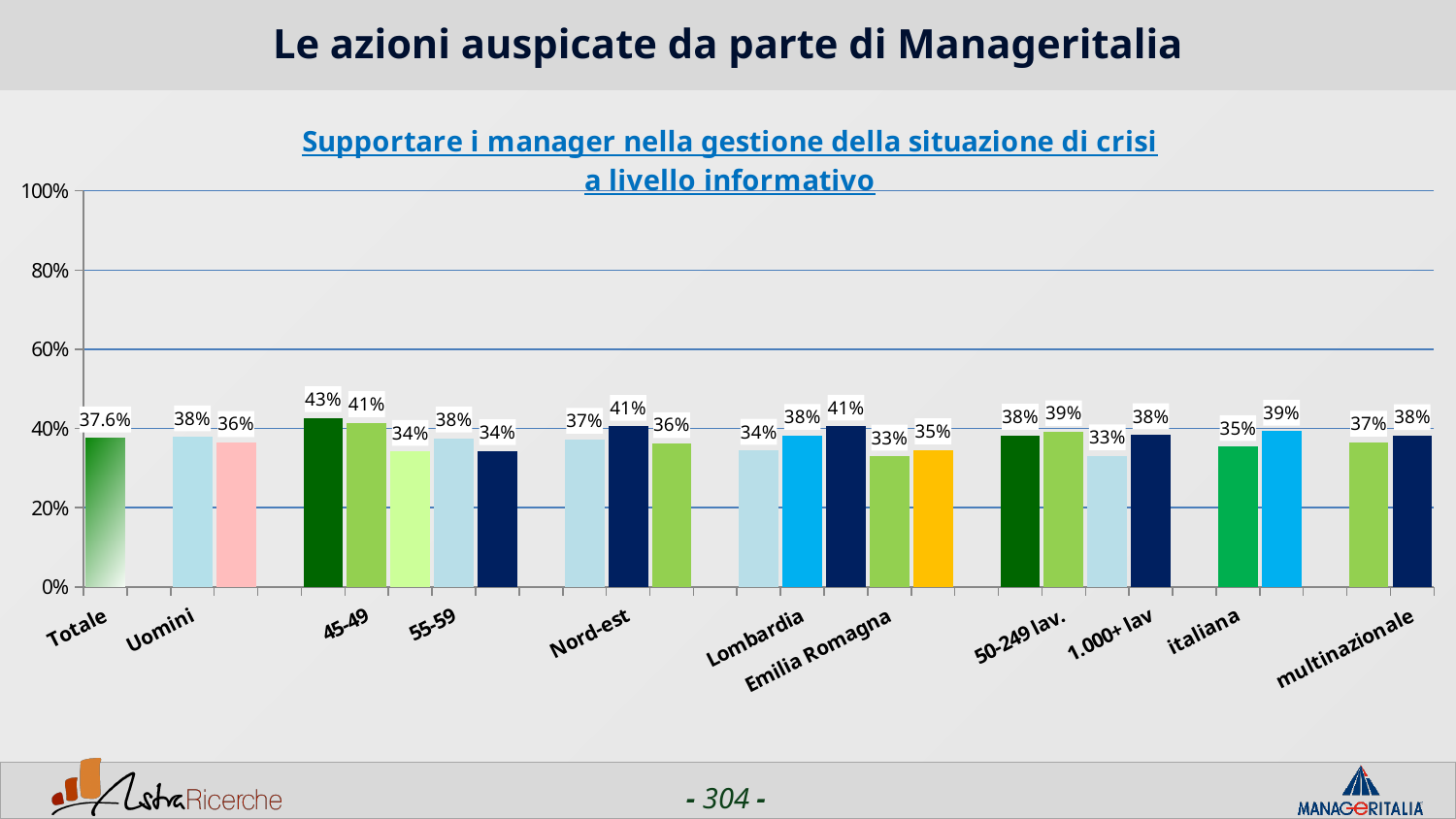
What is the title of the chart? Supportare i manager nella gestione della situazione di crisi a livello informativo What is the value for the 45-49 age group? 41% What is the value for Nord-est? 41% What is the difference between the values for Emilia Romagna and Lombardia? 5 percentage points Which is larger, the value for 45-49 or for 55-59? 45-49 What is the value for 50-249 lav.? 39% What is the value for Uomini? 38% What kind of chart is shown on the slide? Bar chart What is the value for Totale? 37.6% Is the value for multinazionale greater or less than 60%? less What is the value for italiana? 35% What is the value for Emilia Romagna? 33%